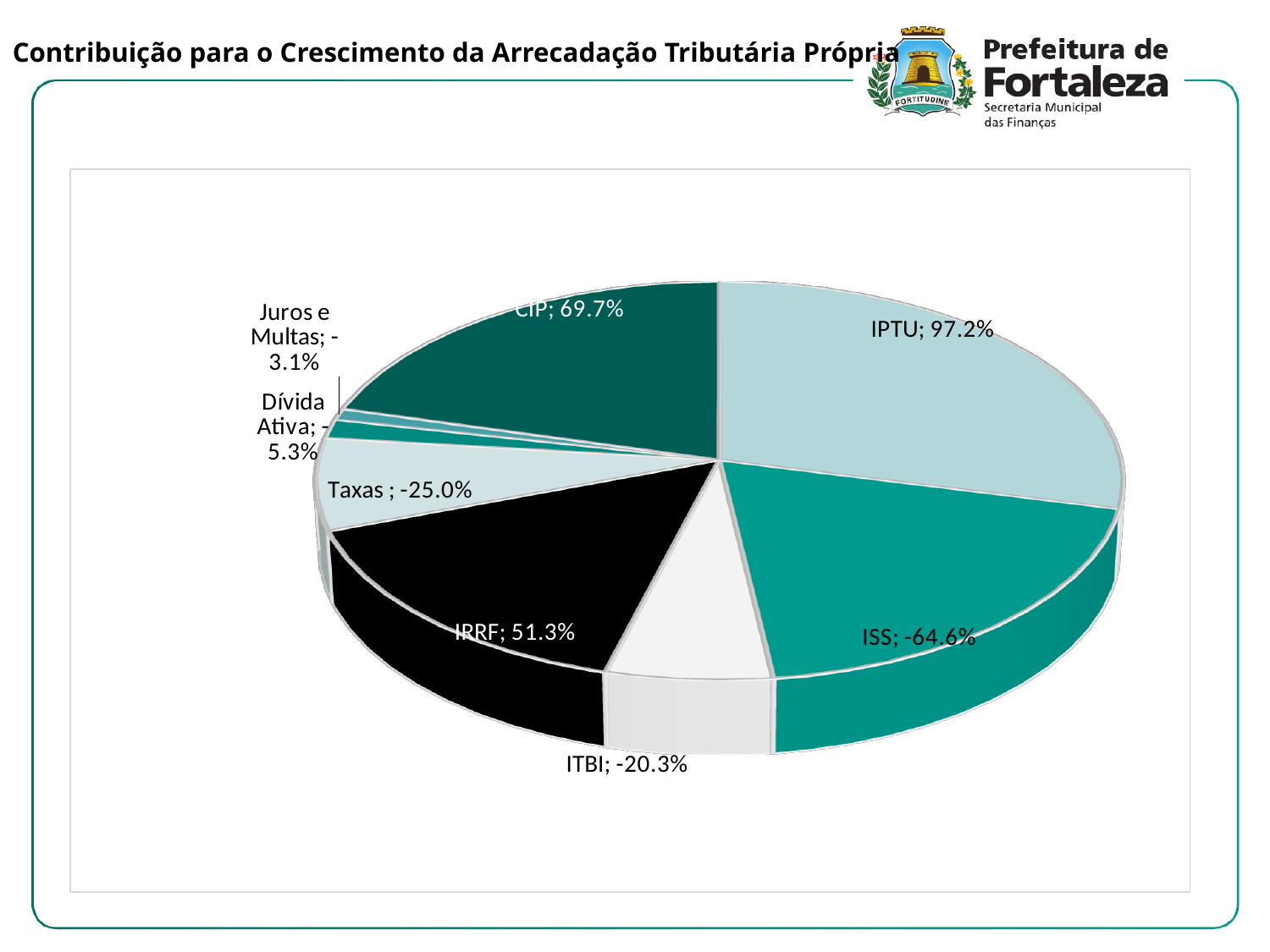
What is the value shown for ISS? -64.6% What kind of chart is shown on the slide? pie chart What is the value shown for ITBI? -20.3% What is the value shown for IPTU? 97.2% What is the value shown for IRRF? 51.3% What is the value shown for Taxas? -25.0% What is the value shown for CIP? 69.7% What is the difference between the values for IPTU and CIP? 27.5 percentage points What is the value shown for Dívida Ativa? -5.3% How many categories are shown in the pie chart? 8 Which category has the highest value? IPTU Which category has the lowest value? ISS